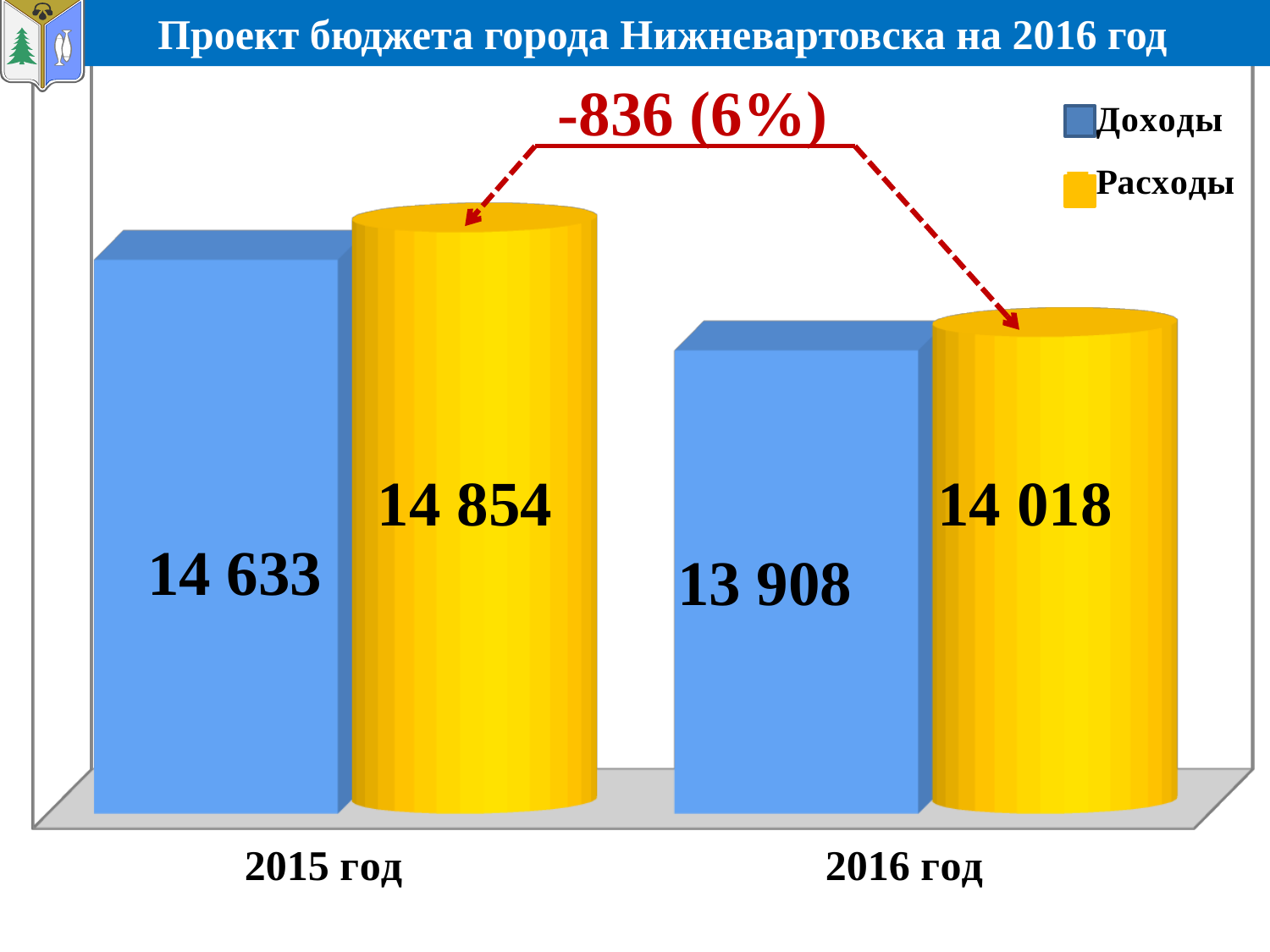
Which year has the higher value of Расходы? 2015 год What is the value of Расходы for 2016 год? 14 018 What percentage change is annotated between Расходы in 2015 год and 2016 год? 6% What is the value of Доходы for 2016 год? 13 908 What is the value of Расходы for 2015 год? 14 854 Which is larger in 2016 год: Доходы or Расходы? Расходы What is the difference between Расходы in 2015 год and Расходы in 2016 год? 836 How many series does the legend list? 2 What kind of chart is shown on the slide? bar chart Which year has the lower value of Доходы? 2016 год What is the difference between Доходы in 2015 год and Доходы in 2016 год? 725 What is the value of Доходы for 2015 год? 14 633